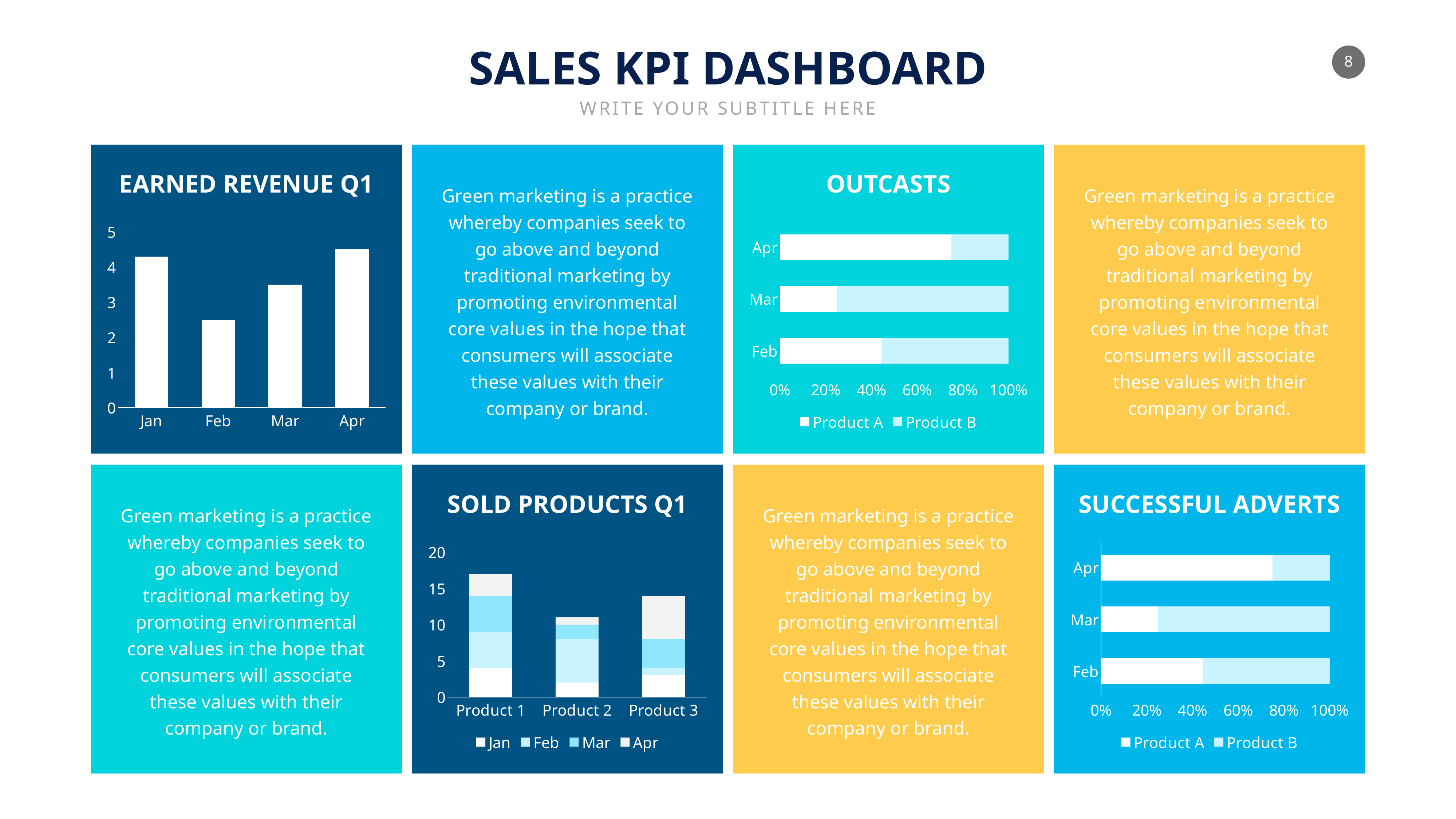
In the Sold Products Q1 chart, is the total for Product 2 greater or less than 15? less In the Earned Revenue Q1 chart, is the value for Feb greater or less than 3? less What kind of chart is the Earned Revenue Q1 chart? bar chart In the Earned Revenue Q1 chart, which month has the lowest bar? Feb In the Sold Products Q1 chart, which product has the tallest stacked bar? Product 1 In the Outcasts chart, which month has the largest share for Product A? Apr In the Earned Revenue Q1 chart, how many months are shown on the x axis? 4 In the Earned Revenue Q1 chart, is the value for Mar greater or less than 3? greater In the Earned Revenue Q1 chart, which month has the highest bar? Apr How many series does the legend of the Sold Products Q1 chart list? 4 In the Successful Adverts chart, which month has the smallest share for Product A? Mar